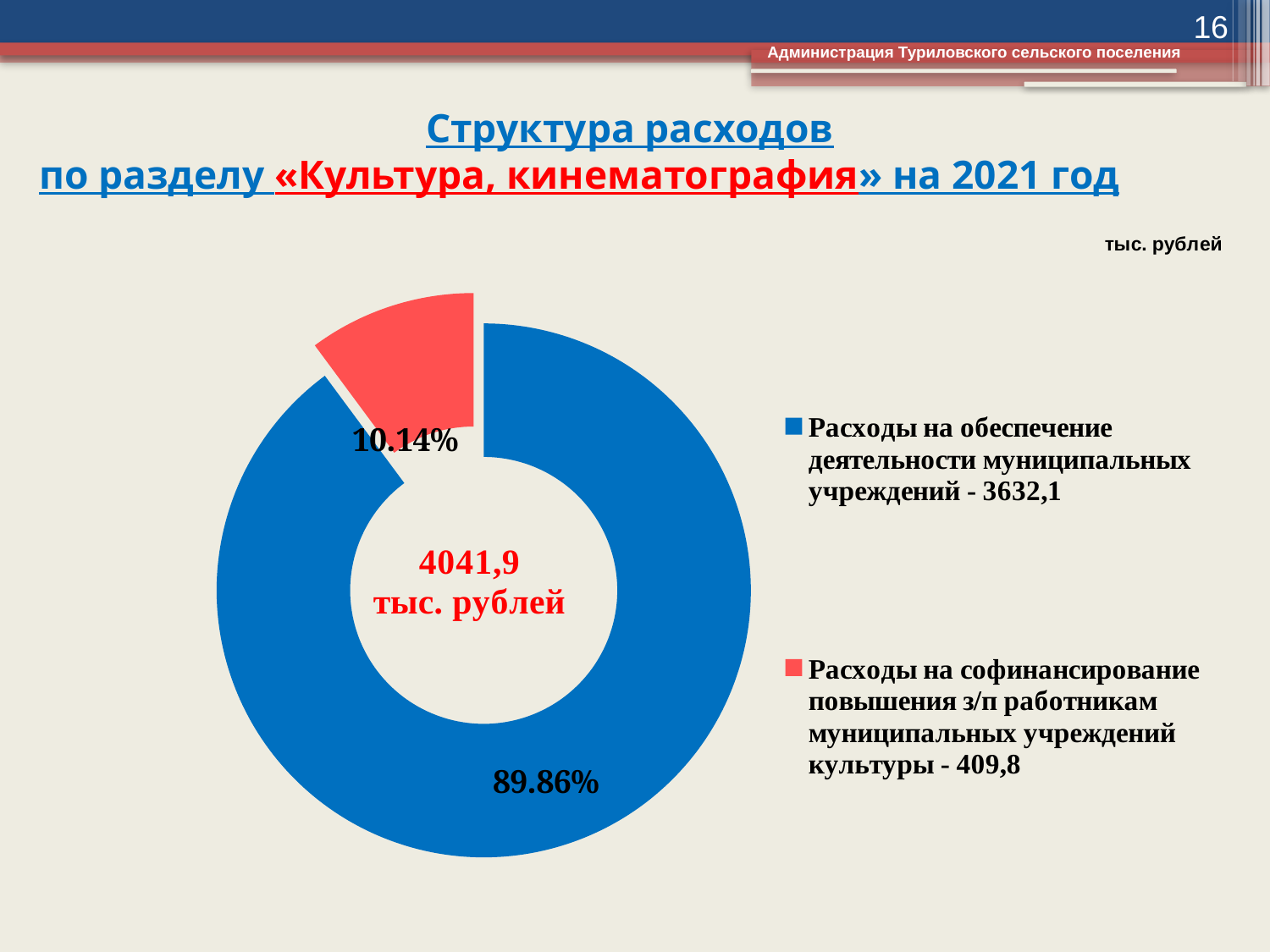
What total amount is shown in the centre of the doughnut chart? 4041,9 тыс. рублей What is the difference in percentage points between the two slices of the chart? 79.72 percentage points Which is larger: the value for «Расходы на обеспечение деятельности муниципальных учреждений» or for «Расходы на софинансирование повышения з/п работникам муниципальных учреждений культуры»? Расходы на обеспечение деятельности муниципальных учреждений Which category has the largest share of the chart? Расходы на обеспечение деятельности муниципальных учреждений What is the value (тыс. рублей) for «Расходы на обеспечение деятельности муниципальных учреждений» according to the legend? 3632,1 What is the value (тыс. рублей) for «Расходы на софинансирование повышения з/п работникам муниципальных учреждений культуры» according to the legend? 409,8 What colour is the slice for «Расходы на софинансирование повышения з/п работникам муниципальных учреждений культуры»? Red What kind of chart is shown on the slide? Doughnut (pie) chart Which category has the smallest share of the chart? Расходы на софинансирование повышения з/п работникам муниципальных учреждений культуры What share of the chart does the slice «Расходы на обеспечение деятельности муниципальных учреждений» take? 89.86% How many categories does the chart show? 2 What share of the chart does the slice «Расходы на софинансирование повышения з/п работникам муниципальных учреждений культуры» take? 10.14%